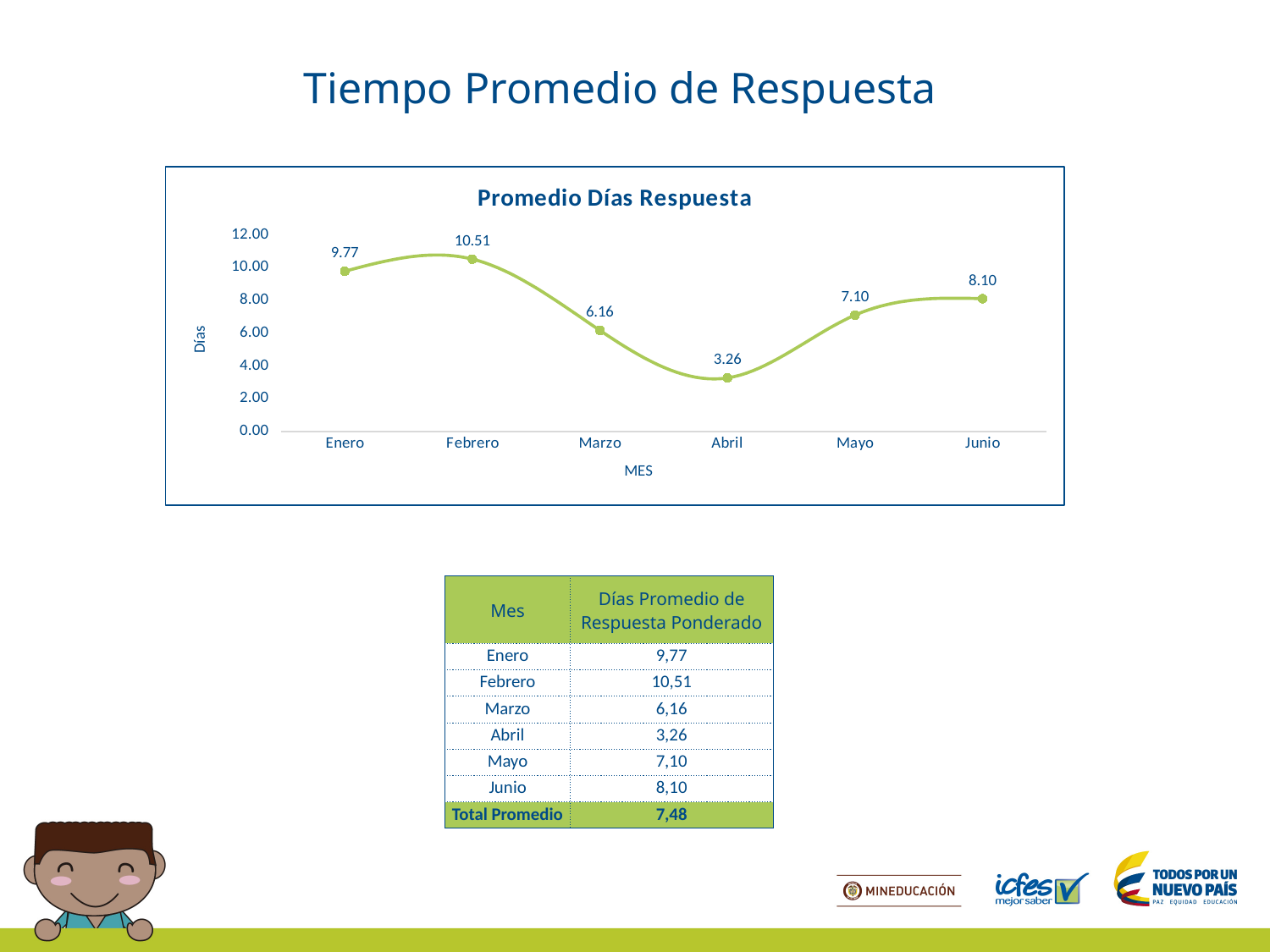
What kind of chart is the Promedio Días Respuesta chart? line chart What is the label of the vertical axis in the Promedio Días Respuesta chart? Días Which month has the lowest value in the Promedio Días Respuesta chart? Abril Do the values in the Promedio Días Respuesta chart rise or fall from Marzo to Abril? fall What is the difference between the values for Febrero and Abril in the Promedio Días Respuesta chart? 7.25 What is the value for Junio in the Promedio Días Respuesta chart? 8.10 What is the value for Febrero in the Promedio Días Respuesta chart? 10.51 Which month has the highest value in the Promedio Días Respuesta chart? Febrero Which is larger in the Promedio Días Respuesta chart, the value for Enero or the value for Junio? Enero Is the value for Marzo in the Promedio Días Respuesta chart greater or less than 8.00? less What is the value for Abril in the Promedio Días Respuesta chart? 3.26 How many months are plotted in the Promedio Días Respuesta chart? 6